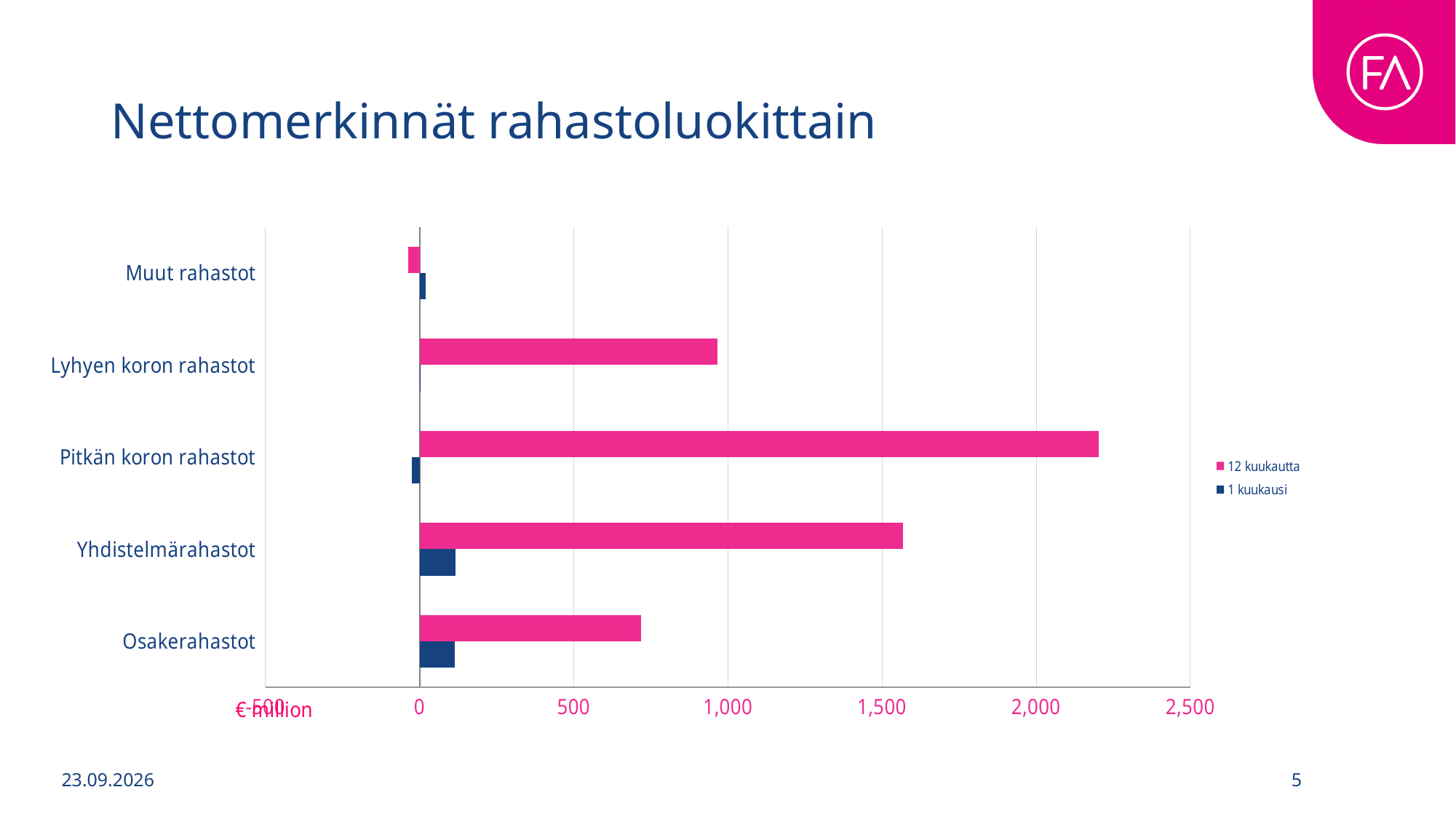
Which category has the lowest value for the 12 kuukautta series? Muut rahastot Is the 12 kuukautta value for Osakerahastot greater or less than 1,000? less How many fund categories are shown on the chart? 5 Is the 12 kuukautta value for Lyhyen koron rahastot greater or less than 500? greater Which category has the highest value for the 12 kuukautta series? Pitkän koron rahastot Is the 12 kuukautta value for Pitkän koron rahastot greater or less than 2,000? greater What kind of chart is shown on the slide? bar chart How many series does the legend list? 2 Which is larger for the 12 kuukautta series: Yhdistelmärahastot or Osakerahastot? Yhdistelmärahastot What is the title of the chart on the slide? Nettomerkinnät rahastoluokittain Which series is shown in pink? 12 kuukautta